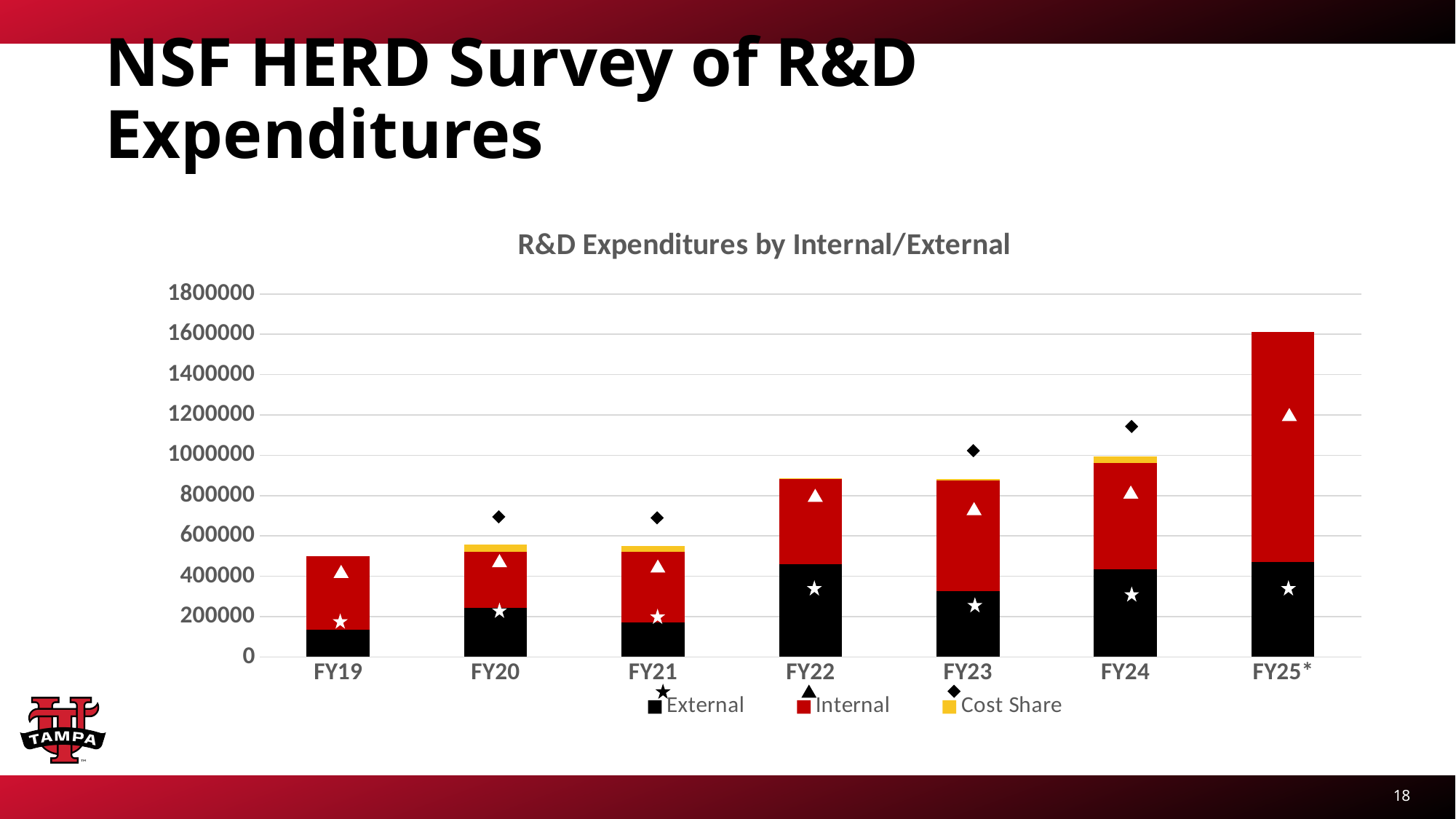
Is the total bar for FY25* greater or less than 1400000? greater Which fiscal year has the shortest stacked bar? FY19 Which fiscal year has the tallest stacked bar? FY25* How many series does the legend list? 3 Is the total bar for FY22 greater or less than 800000? greater Which has the taller total bar, FY20 or FY22? FY22 What is the title of the chart? R&D Expenditures by Internal/External Is the total bar for FY19 greater or less than 600000? less How many fiscal years are shown on the x axis? 7 What kind of chart is shown on the slide? stacked bar chart Do the total R&D expenditures generally rise or fall from FY19 to FY25*? rise